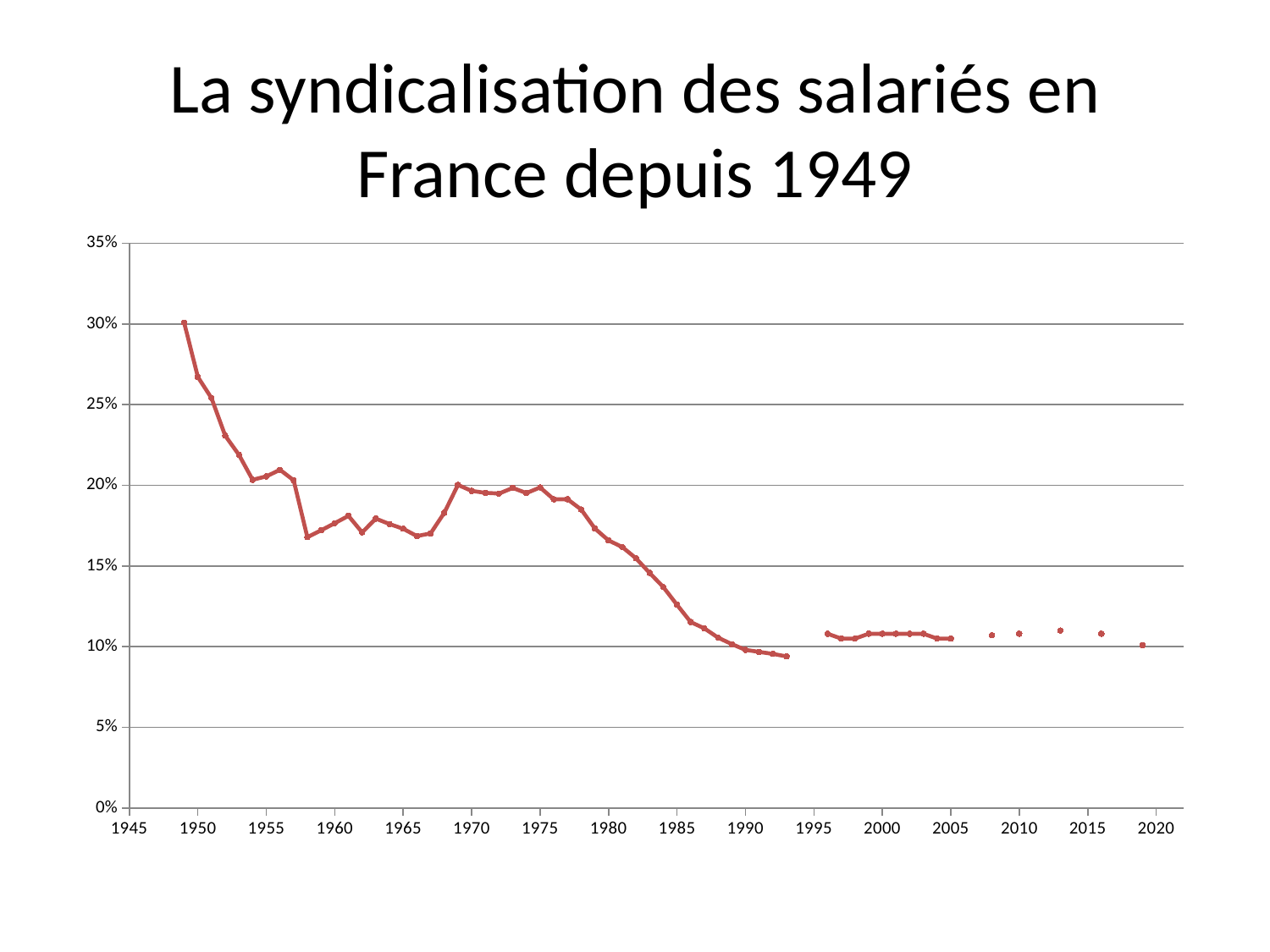
Which year has the larger value, 1958 or 1969? 1969 Is the value for 1985 greater or less than 15%? less Overall, do the values rise or fall from 1949 to 2019? fall In which year is the plotted value highest? 1949 Is the value for 1993 greater or less than 10%? less Is the value for 1949 greater or less than 25%? greater What is the highest value shown on the vertical axis of the chart? 35% What kind of chart is shown on the slide? line chart Which year has the larger value, 1949 or 1993? 1949 What is the title of the chart on the slide? La syndicalisation des salariés en France depuis 1949